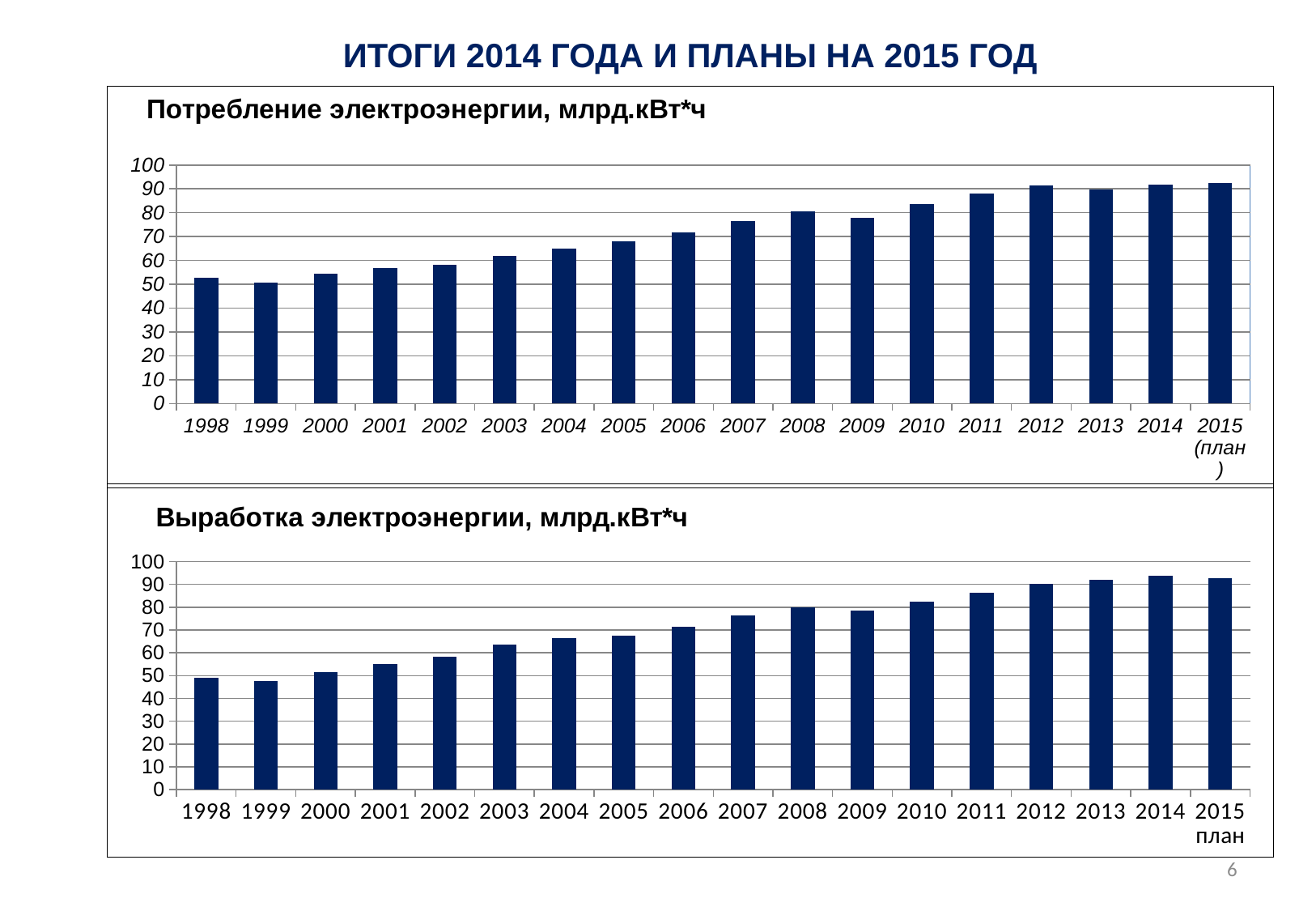
What kind of chart is the top chart titled "Потребление электроэнергии, млрд.кВт*ч"? bar chart In the top chart (Потребление электроэнергии), which year has the lowest value? 1999 In the bottom chart (Выработка электроэнергии), which year has the lowest value? 1999 In the bottom chart (Выработка электроэнергии), how many years are shown on the x axis? 18 In the top chart (Потребление электроэнергии), how many years are shown on the x axis? 18 In the bottom chart (Выработка электроэнергии), is the value for 2012 greater or less than 80? greater In the top chart (Потребление электроэнергии), is the value for 1998 greater or less than 60? less In the top chart (Потребление электроэнергии), which is larger, the value for 2008 or the value for 2009? 2008 What is the title of the bottom chart on the slide? Выработка электроэнергии, млрд.кВт*ч In the top chart (Потребление электроэнергии), is the value for 2010 greater or less than 80? greater In the top chart (Потребление электроэнергии), do the values generally rise or fall from 1998 to 2015? rise